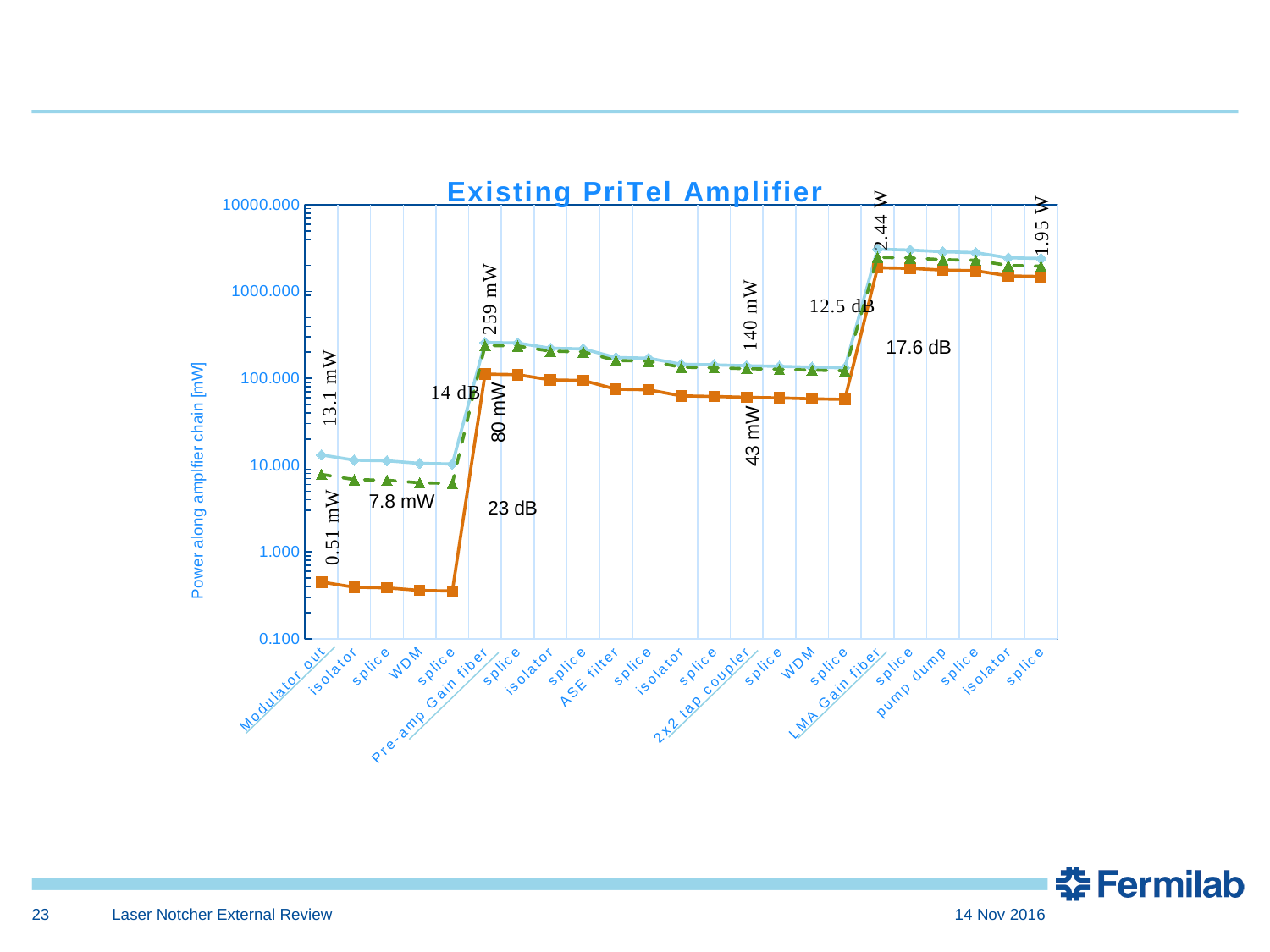
What is the title of the chart? Existing PriTel Amplifier Is the value of the bottom (orange) line at the Modulator out stage greater or less than 1.000? less Is the value of the top (blue) line after the LMA Gain fiber greater or less than 1000.000? greater What is the label of the vertical axis? Power along amplfier chain [mW] What power is annotated for the top (blue) line at the final splice at the right end of the chain? 1.95 W What power is annotated for the top (blue) line just after the Pre-amp Gain fiber? 259 mW How many categories are listed along the x axis? 23 What power is annotated for the top (blue) line at the 2x2 tap coupler? 140 mW What power is annotated for the top (blue) line at the Modulator out stage? 13.1 mW What power is annotated for the bottom (orange) line just after the Pre-amp Gain fiber? 80 mW What type of chart is shown on the slide? line chart What power is annotated for the bottom (orange) line at the Modulator out stage? 0.51 mW